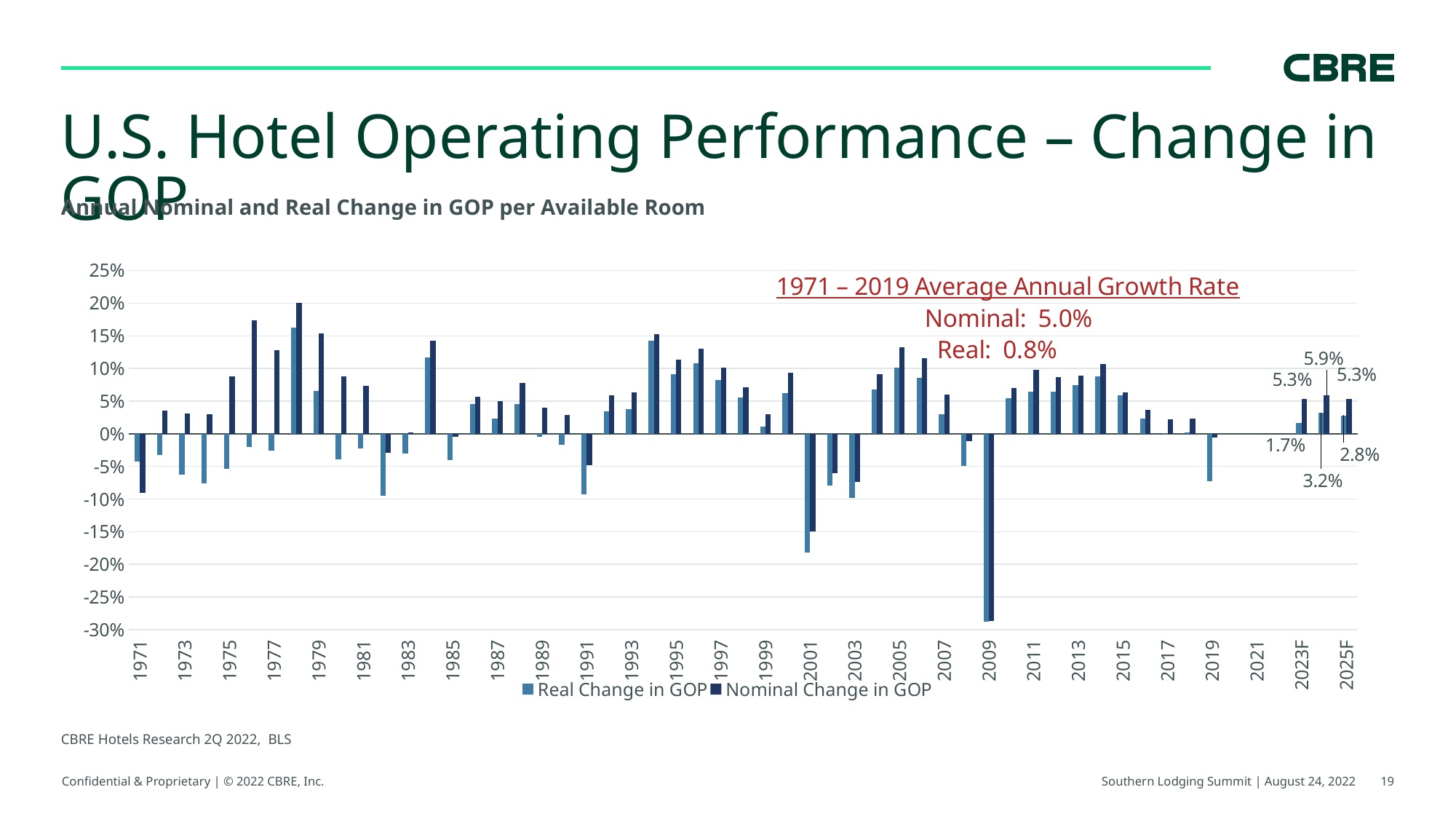
Which year has the larger Real Change in GOP, 2023F or 2025F? 2025F Which year has the larger Nominal Change in GOP, 2023F or 2024F? 2024F Which year has the lowest Nominal Change in GOP? 2009 What is the Real Change in GOP for 2025F? 2.8% What is the difference between the Nominal and Real Change in GOP for 2024F? 2.7% What is the Nominal Change in GOP for 2024F? 5.9% What is the Real Change in GOP for 2023F? 1.7% According to the annotation on the chart, what is the 1971–2019 average annual nominal growth rate? 5.0% How many series does the chart legend list? 2 What kind of chart is shown on the slide? bar chart Is the Nominal Change in GOP for 1978 greater or less than 15%? greater Is the Nominal Change in GOP for 2009 greater or less than -25%? less